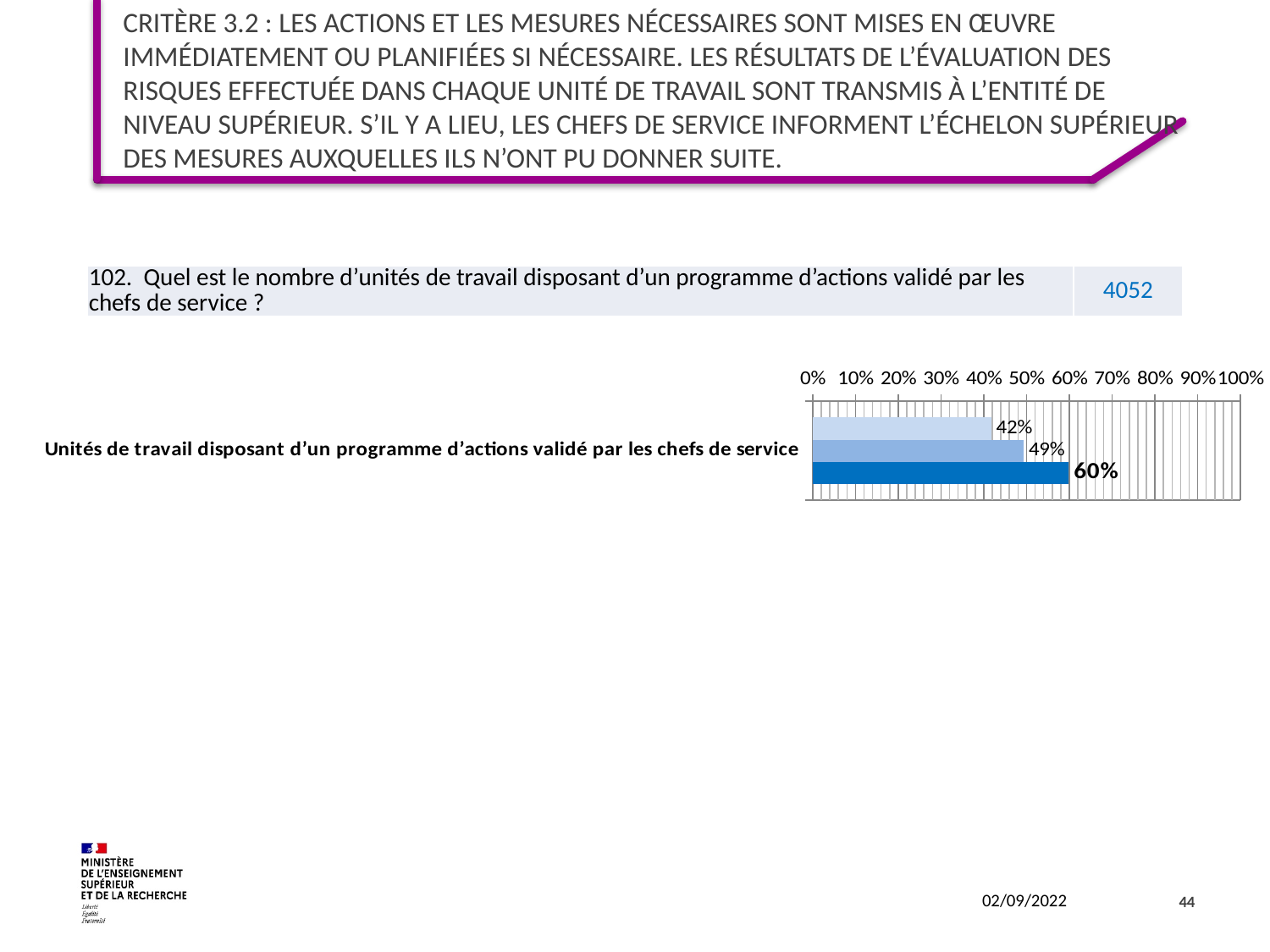
How many bars are plotted in the chart? 3 What value is printed on the bottom (darkest blue) bar of the chart? 60% What is the difference between the bottom bar (60%) and the top bar (42%)? 18% What kind of chart is shown on the slide? bar chart What value is printed on the top (lightest blue) bar of the chart? 42% Which of the three bars has the lowest value? the top (lightest blue) bar, 42% Which of the three bars has the highest value? the bottom (darkest blue) bar, 60% What is the category label shown to the left of the bars? Unités de travail disposant d'un programme d'actions validé par les chefs de service What value is printed on the middle bar of the chart? 49% What is the difference between the middle bar (49%) and the top bar (42%)? 7% Is the middle bar's value larger or smaller than the bottom bar's value? smaller Is the value of the top bar greater or less than 50%? less